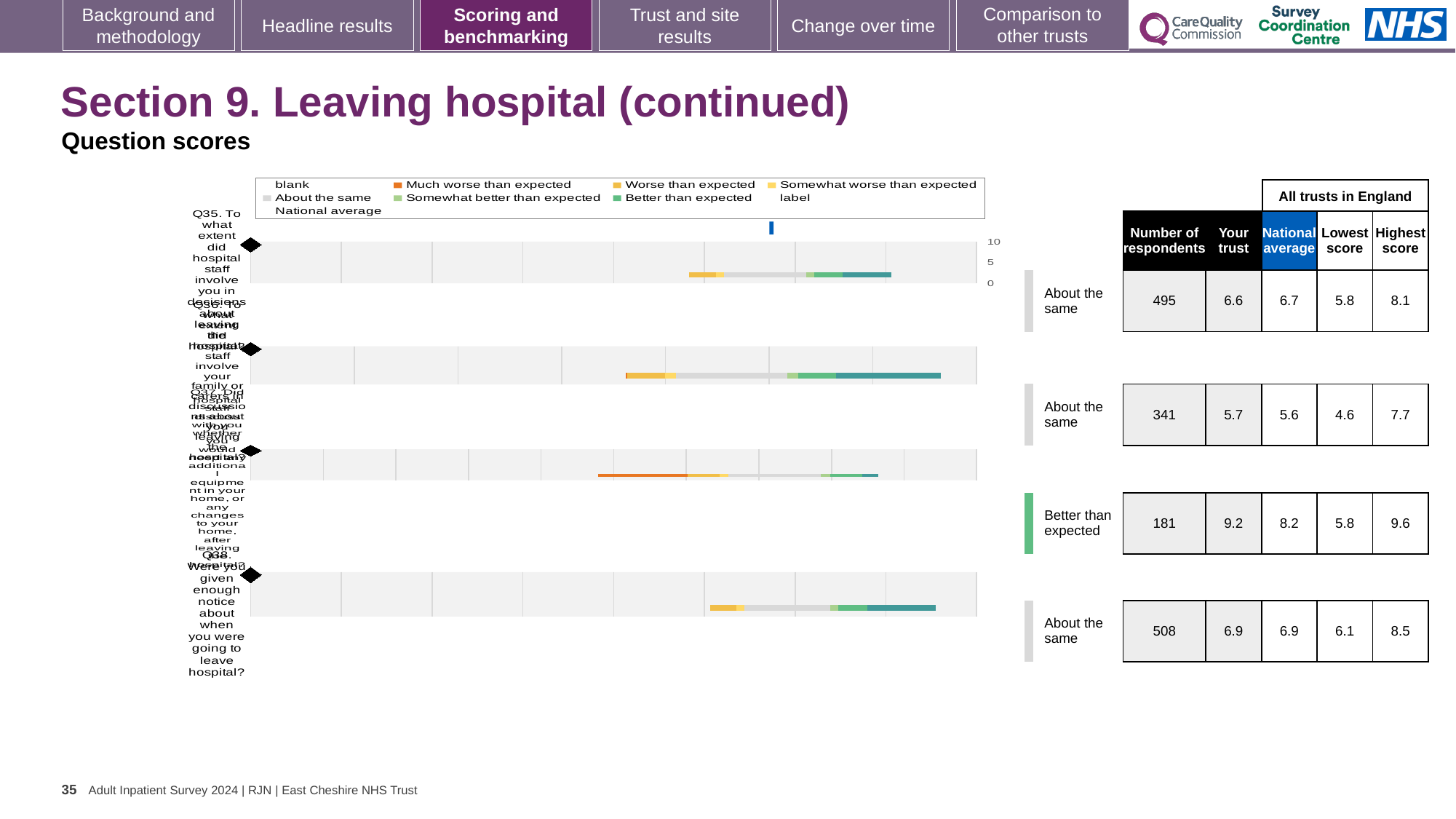
What is the national average for Q35 (the top bar)? 6.7 How many respondents are listed for Q38 (the bottom bar)? 508 How many entries does the chart legend list? 9 How many question bars are plotted in the chart? 4 What is the 'Your trust' score for the second bar from the top? 5.7 For Q38 (the bottom bar), what is the difference between the highest score and the lowest score across all trusts in England? 2.4 What is the 'Your trust' score for Q35 (the top bar)? 6.6 Which bar has the highest 'Your trust' score? The third bar from the top (9.2) What benchmark category is shown for the third bar from the top? Better than expected For Q35 (the top bar), which is larger: the 'Your trust' score or the national average? National average What kind of chart is shown on the slide? Bar chart What is the lowest score across all trusts in England for Q38 (the bottom bar)? 6.1